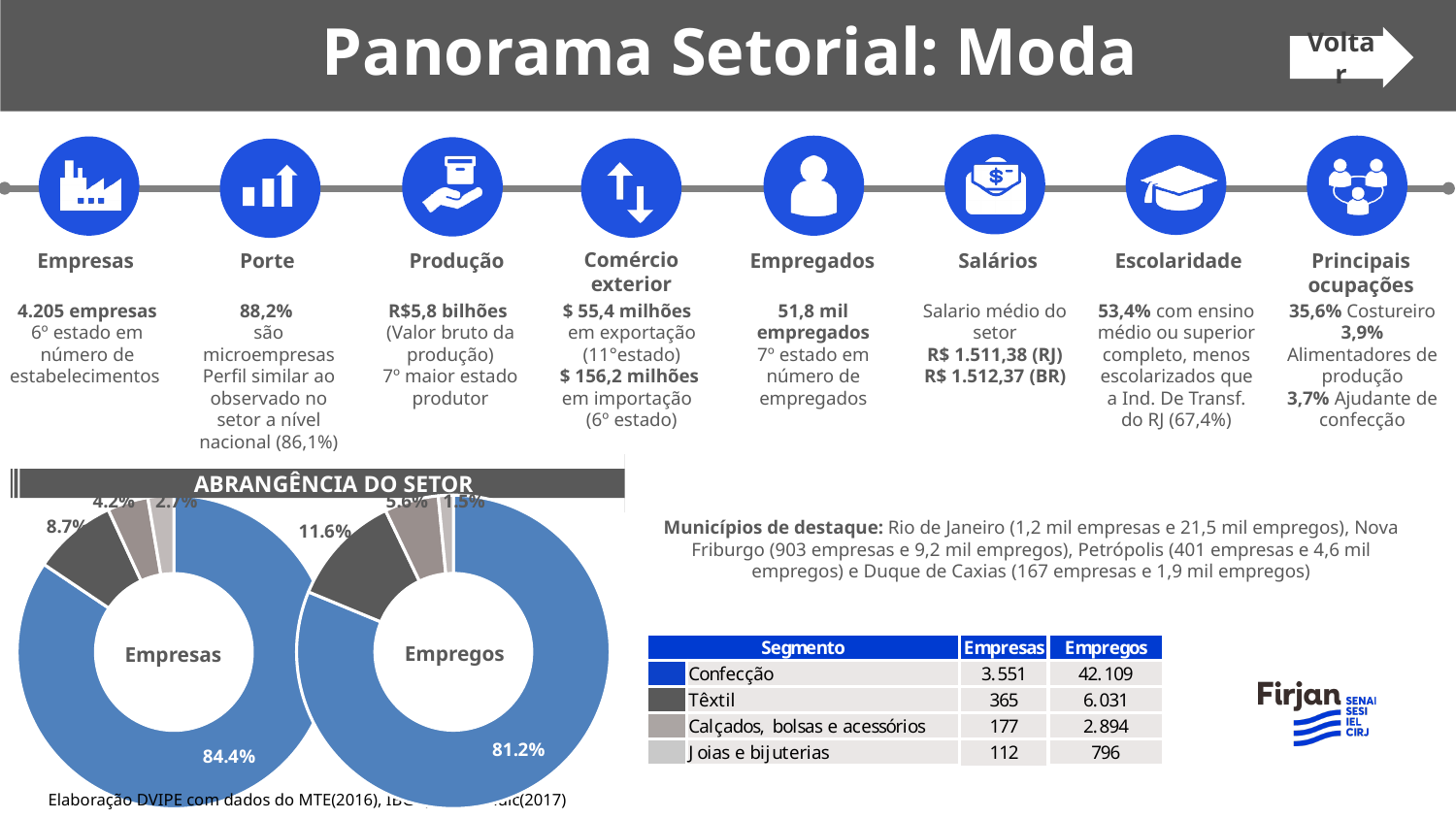
In the "Empregos" donut chart, what is the share of the dark grey slice (Têxtil)? 11.6% How many slices does each donut chart have? 4 In the "Empresas" donut chart, what share does the largest slice have? 84.4% Is the Têxtil share larger in the "Empresas" chart or in the "Empregos" chart? Empregos Which segment has the largest slice in the "Empresas" donut chart? Confecção What kind of charts are the two charts under "ABRANGÊNCIA DO SETOR"? Donut (pie) charts In the "Empresas" donut chart, what is the share of the medium grey slice (Calçados, bolsas e acessórios)? 4.2% What is the difference between the Têxtil share in the "Empregos" chart (11.6%) and in the "Empresas" chart (8.7%)? 2.9 percentage points Which segment has the smallest slice in the "Empregos" donut chart? Joias e bijuterias In the "Empregos" donut chart, what is the share of the medium grey slice (Calçados, bolsas e acessórios)? 5.6% In the "Empregos" donut chart, what share does the largest slice have? 81.2% In the "Empresas" donut chart, what is the share of the dark grey slice (Têxtil)? 8.7%